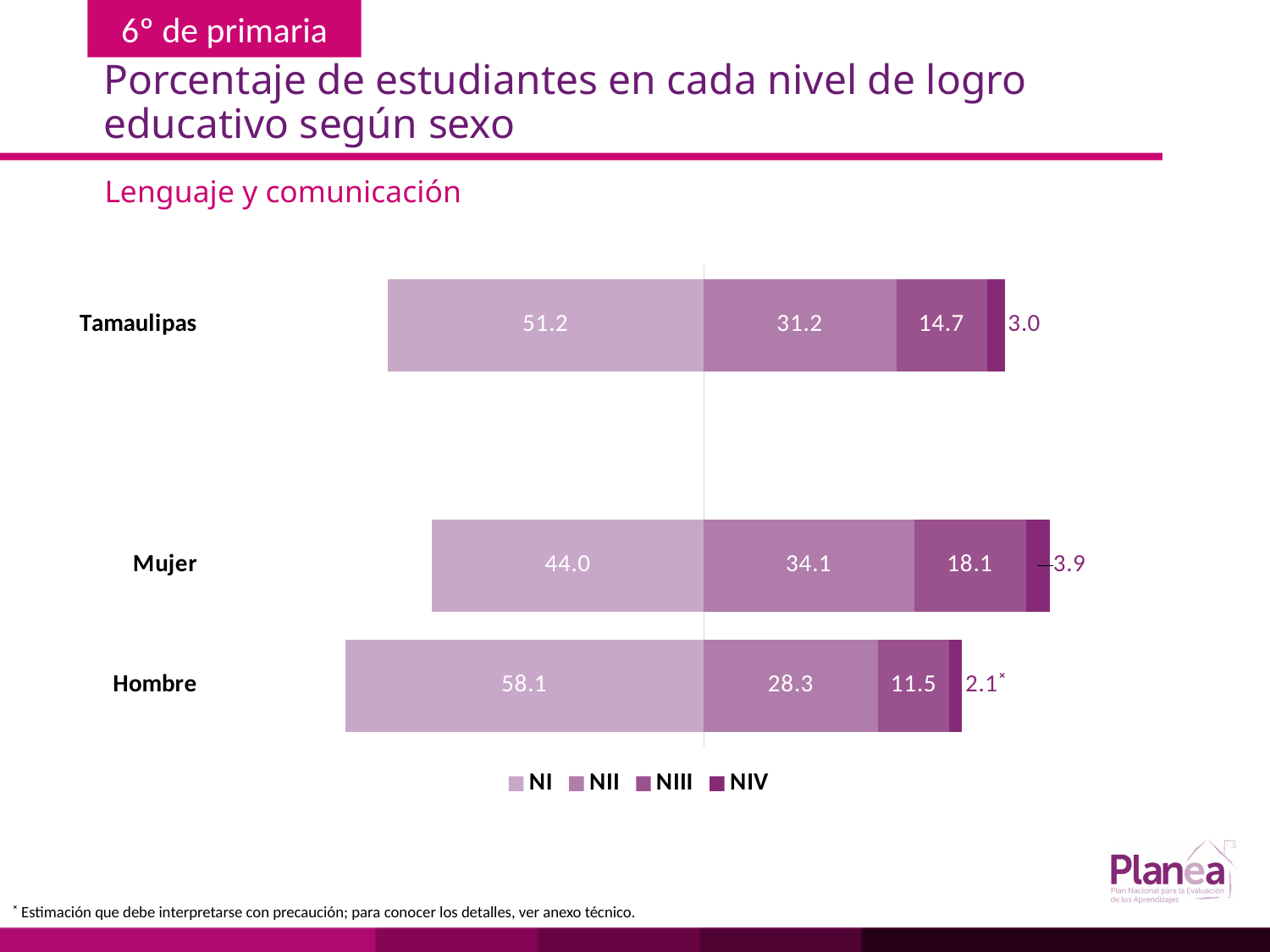
What is the difference between the NI values for Hombre and Mujer? 14.1 Which category has the lowest NIII value? Hombre What is the NIV value for Mujer? 3.9 What is the NI value for Hombre? 58.1 Which category has the highest NI value? Hombre What kind of chart is shown on the slide? Stacked bar chart What is the NII value for Mujer? 34.1 What is the NIII value for Tamaulipas? 14.7 How many series does the legend list? 4 Which is larger, the NII value for Tamaulipas or the NII value for Hombre? Tamaulipas What is the total of the stacked bar for Tamaulipas? 100.1 How many categories are shown on the chart? 3